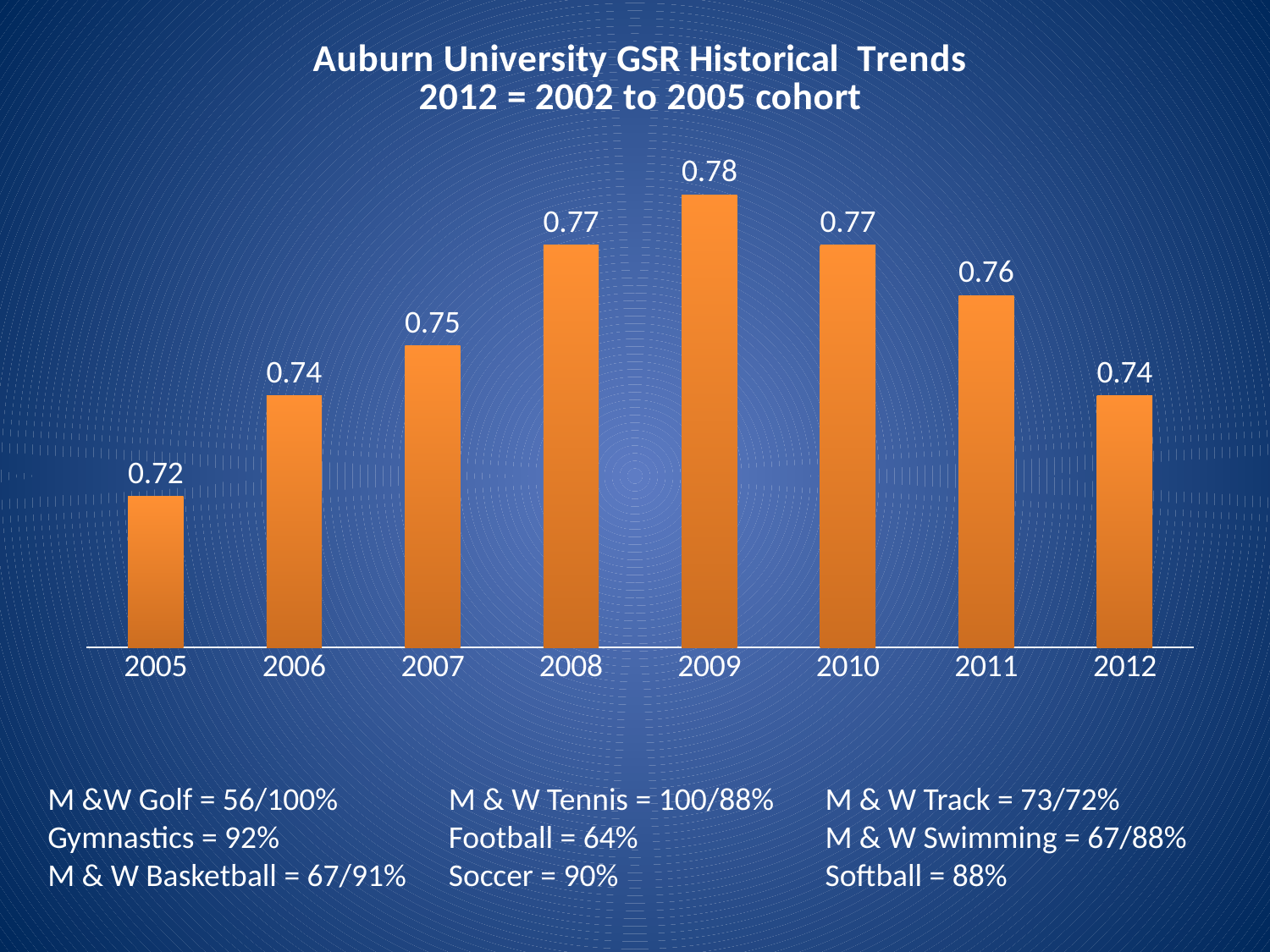
What is the value for 2011? 0.76 What is the value for 2009? 0.78 What is the value for 2012? 0.74 Which year has the highest value? 2009 What is the difference between the values for 2009 and 2005? 0.06 What kind of chart is shown on the slide? bar chart What is the difference between the values for 2008 and 2012? 0.03 What is the title of the chart? Auburn University GSR Historical Trends 2012 = 2002 to 2005 cohort How many years are shown on the x axis? 8 Which is larger, the value for 2007 or the value for 2011? 2011 What is the value for 2005? 0.72 Which year has the lowest value? 2005